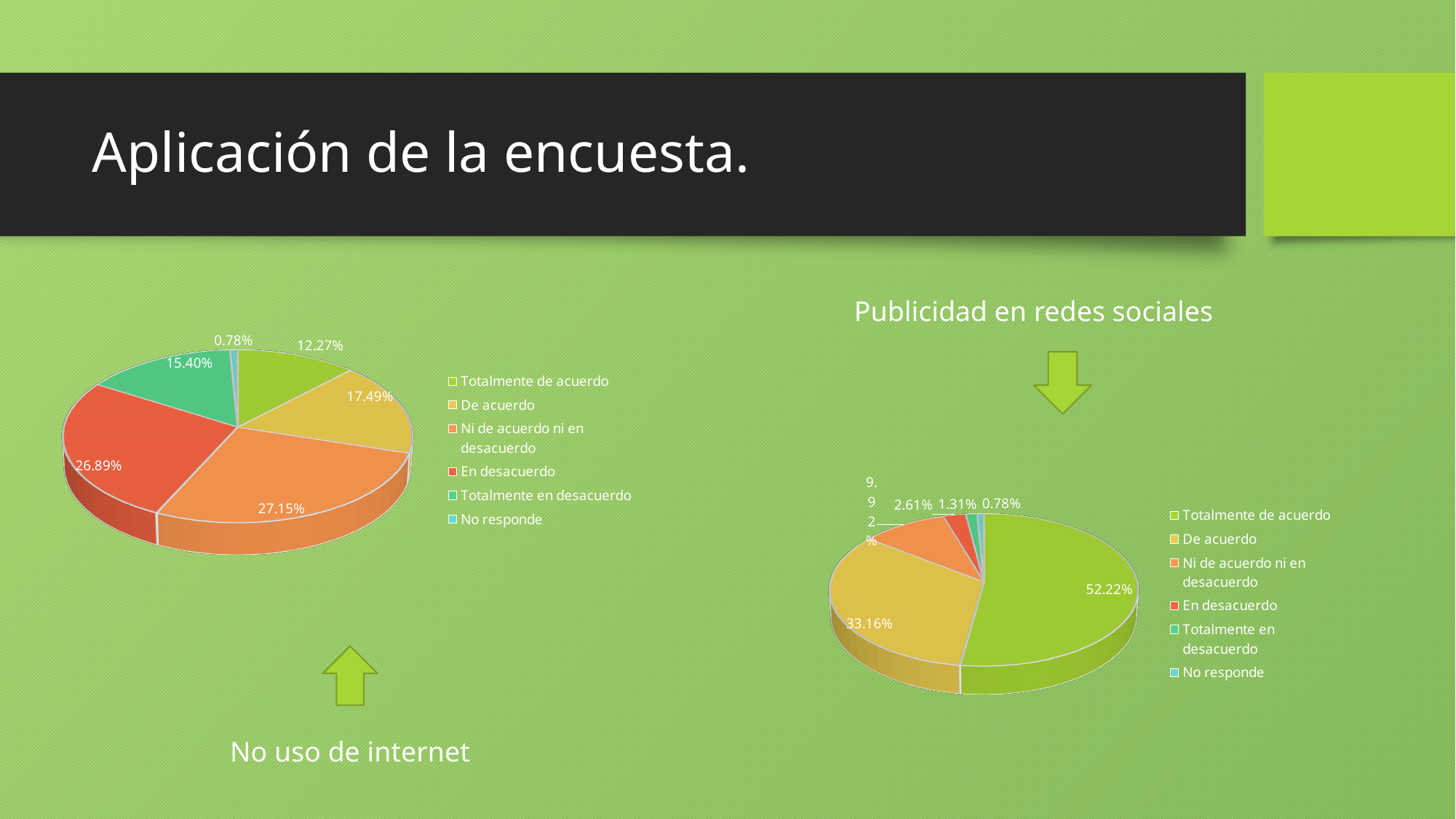
In the 'No uso de internet' pie chart, what is the difference between 'De acuerdo' and 'Totalmente de acuerdo'? 5.22% In the 'Publicidad en redes sociales' pie chart, which is larger, 'Totalmente de acuerdo' or 'De acuerdo'? Totalmente de acuerdo In the 'No uso de internet' pie chart, what percentage is shown for 'Totalmente en desacuerdo'? 15.40% In the 'Publicidad en redes sociales' pie chart, what percentage is shown for 'De acuerdo'? 33.16% In the 'Publicidad en redes sociales' pie chart, what percentage is shown for 'En desacuerdo'? 2.61% In the 'Publicidad en redes sociales' pie chart, what percentage is shown for 'Totalmente de acuerdo'? 52.22% In the 'No uso de internet' pie chart, which category has the largest share? Ni de acuerdo ni en desacuerdo In the 'No uso de internet' pie chart, which category has the smallest share? No responde How many categories does the legend of the 'Publicidad en redes sociales' chart list? 6 In the 'No uso de internet' pie chart, what percentage is shown for 'En desacuerdo'? 26.89% In the 'No uso de internet' pie chart, what percentage is shown for 'Totalmente de acuerdo'? 12.27% What type of chart is used for 'No uso de internet'? Pie chart